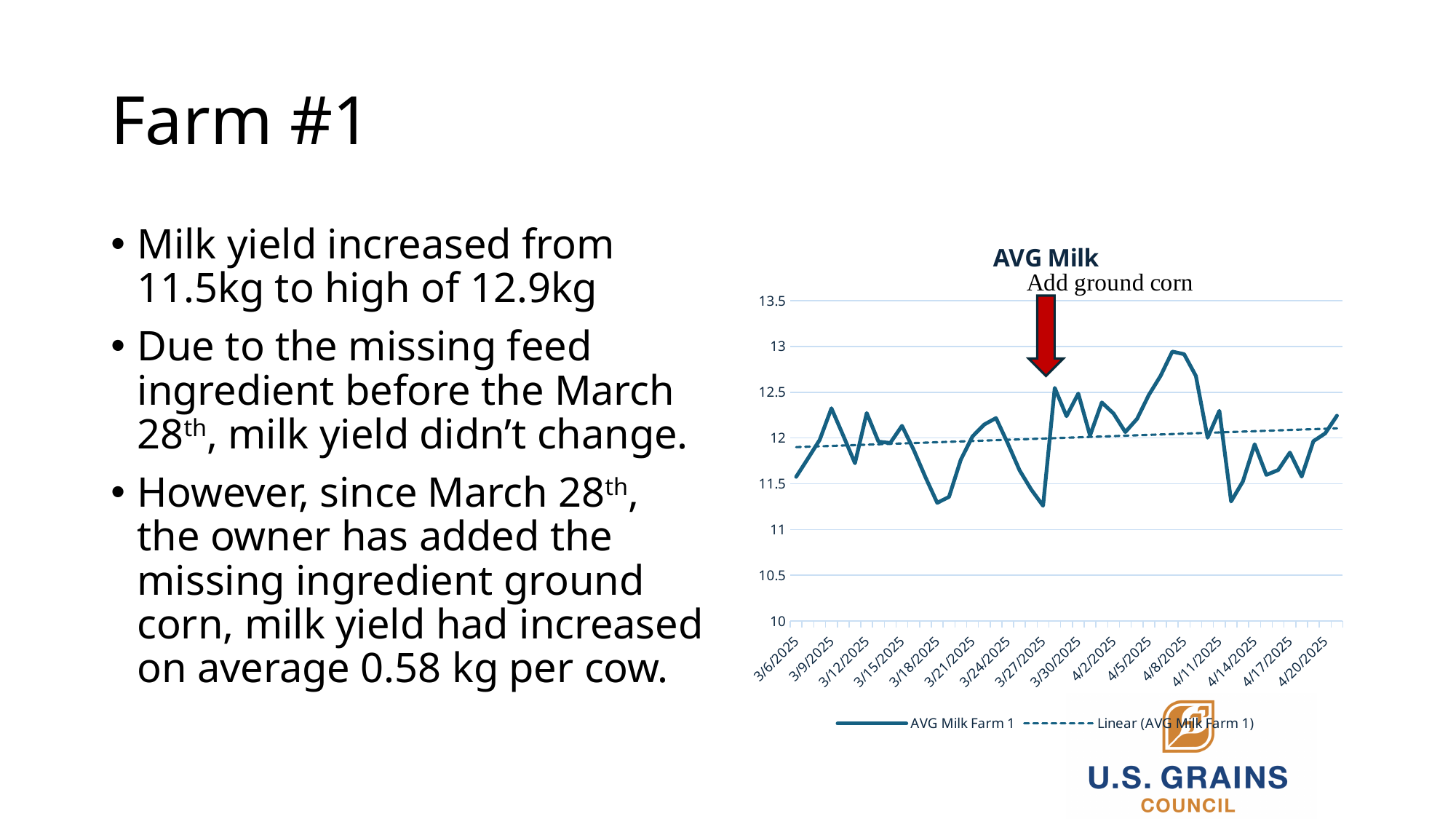
Is the value for 3/30/2025 greater or less than 12? greater Is the value for 4/8/2025 greater or less than 12.5? greater Does the dashed linear trendline rise or fall from left to right? rise Is the value for 3/6/2025 greater or less than 12? less How many date labels are shown on the x axis? 16 Which is larger, the value for 4/8/2025 or the value for 3/27/2025? 4/8/2025 What does the red arrow annotation on the chart say? Add ground corn How many entries does the chart legend list? 2 What is the title of the chart? AVG Milk What kind of chart is shown on the slide? Line chart